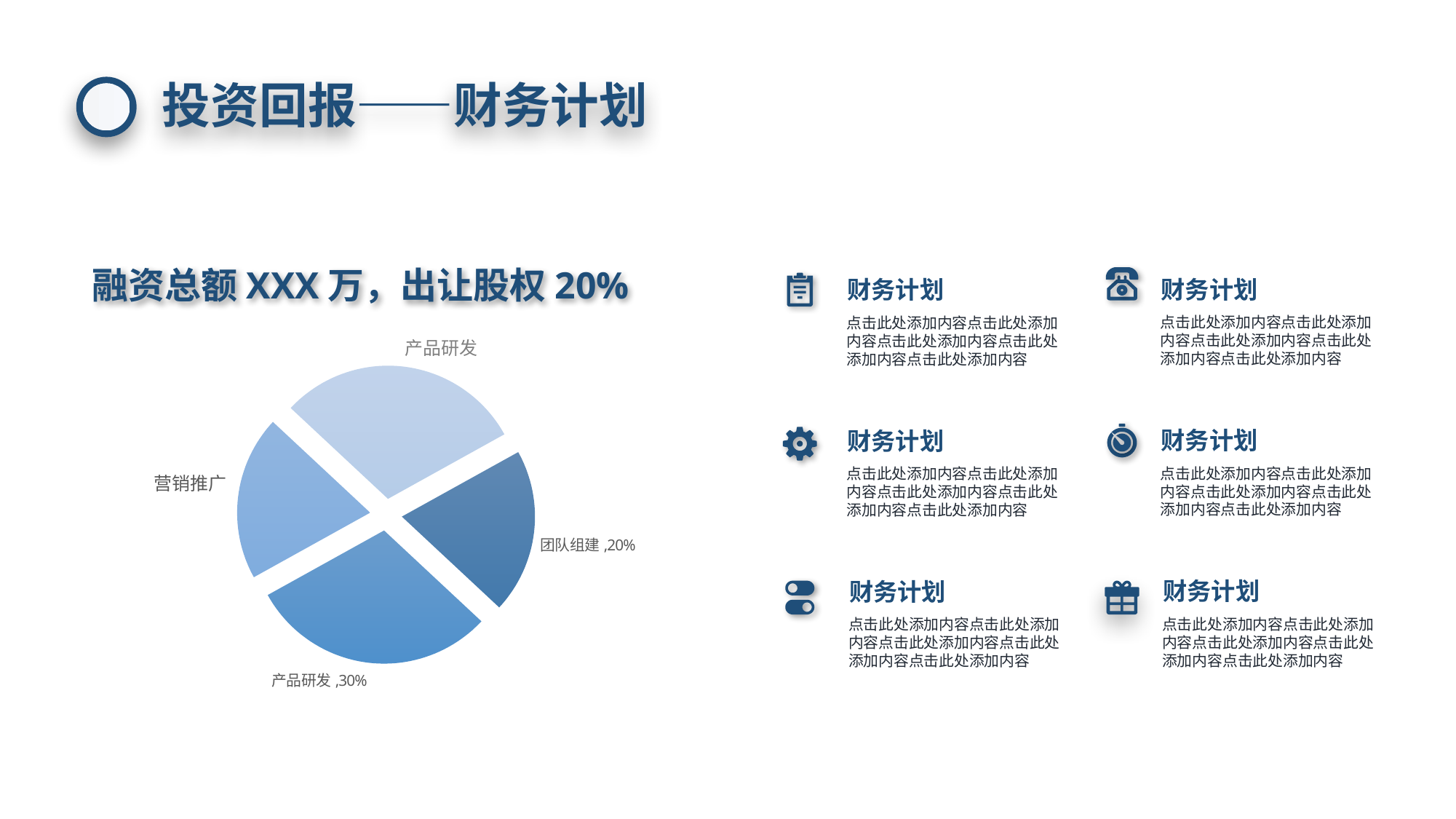
What percentage is shown for 团队组建 in the pie chart? 20% What kind of chart is shown on the left of the slide? pie chart Is the value for 团队组建 in the pie chart greater or less than 25%? less What is the difference between the percentage of the bottom slice (30%) and 团队组建 (20%)? 10 percentage points How many slices does the pie chart have? 4 How many slices in the pie chart have a percentage printed in their label? 2 Which is larger in the pie chart: the 团队组建 slice or the bottom slice labeled 产品研发? the bottom slice labeled 产品研发 What percentage is printed on the label of the slice at the bottom of the pie chart? 30% What is the label of the slice on the left side of the pie chart? 营销推广